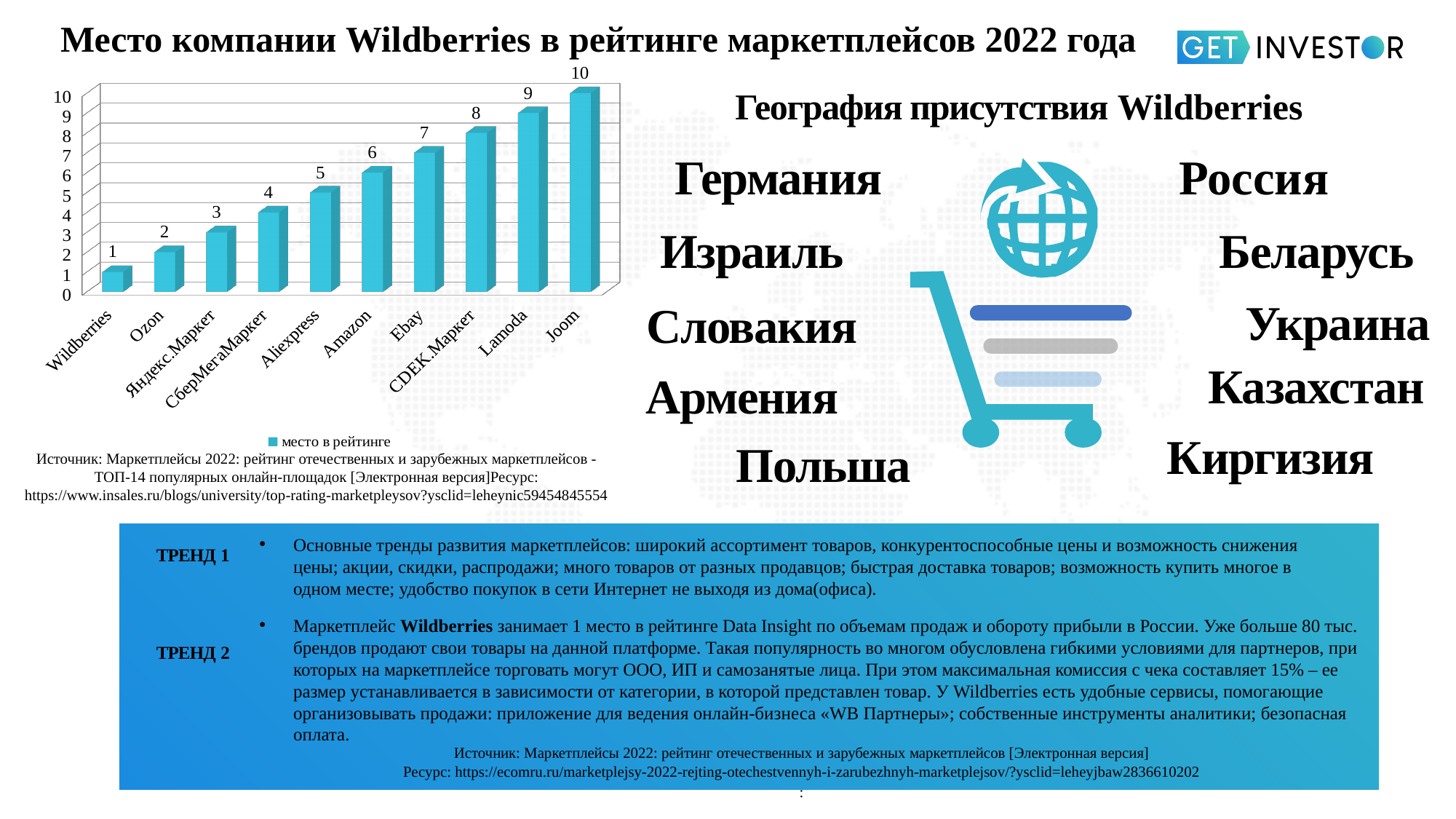
Do the values rise or fall from left to right along the x axis? Rise What is the legend entry of the chart? место в рейтинге What kind of chart is shown on the slide? Bar chart What is the value shown for Lamoda in the chart? 9 Which category has the lowest value in the chart? Wildberries What is the value shown for Wildberries in the chart? 1 Which category has the highest value in the chart? Joom How many series does the chart legend list? 1 What is the value shown for Amazon in the chart? 6 What is the difference between the values for Joom and Ozon? 8 Which has a larger value in the chart, Ebay or Aliexpress? Ebay How many categories are shown on the x axis of the chart? 10